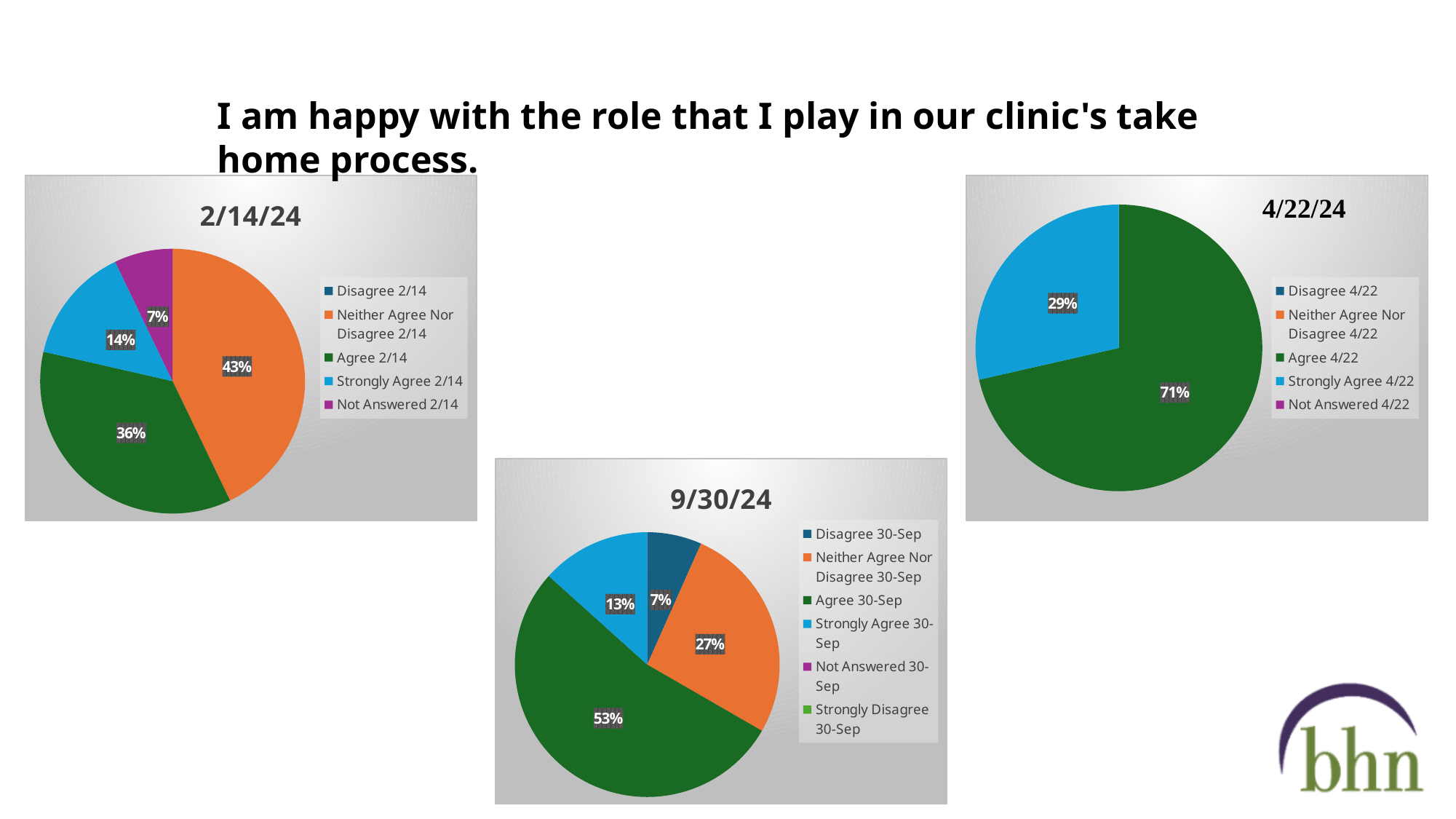
In the 2/14/24 pie chart, which category has the smallest slice? Not Answered 2/14 In the 2/14/24 pie chart, what percentage is shown for Agree? 36% How many entries does the legend of the 9/30/24 pie chart list? 6 In the 9/30/24 pie chart, what percentage is shown for Disagree? 7% In the 2/14/24 pie chart, what percentage is shown for Neither Agree Nor Disagree? 43% In the 2/14/24 pie chart, what is the difference between the Neither Agree Nor Disagree slice and the Strongly Agree slice? 29% In the 4/22/24 pie chart, what percentage is shown for Strongly Agree? 29% What kind of chart is the 4/22/24 chart? Pie chart In the 9/30/24 pie chart, what percentage is shown for Agree? 53% In the 4/22/24 pie chart, which category has the largest slice? Agree 4/22 In the 9/30/24 pie chart, which is larger, Neither Agree Nor Disagree or Strongly Agree? Neither Agree Nor Disagree How many pie charts are shown on the slide? 3